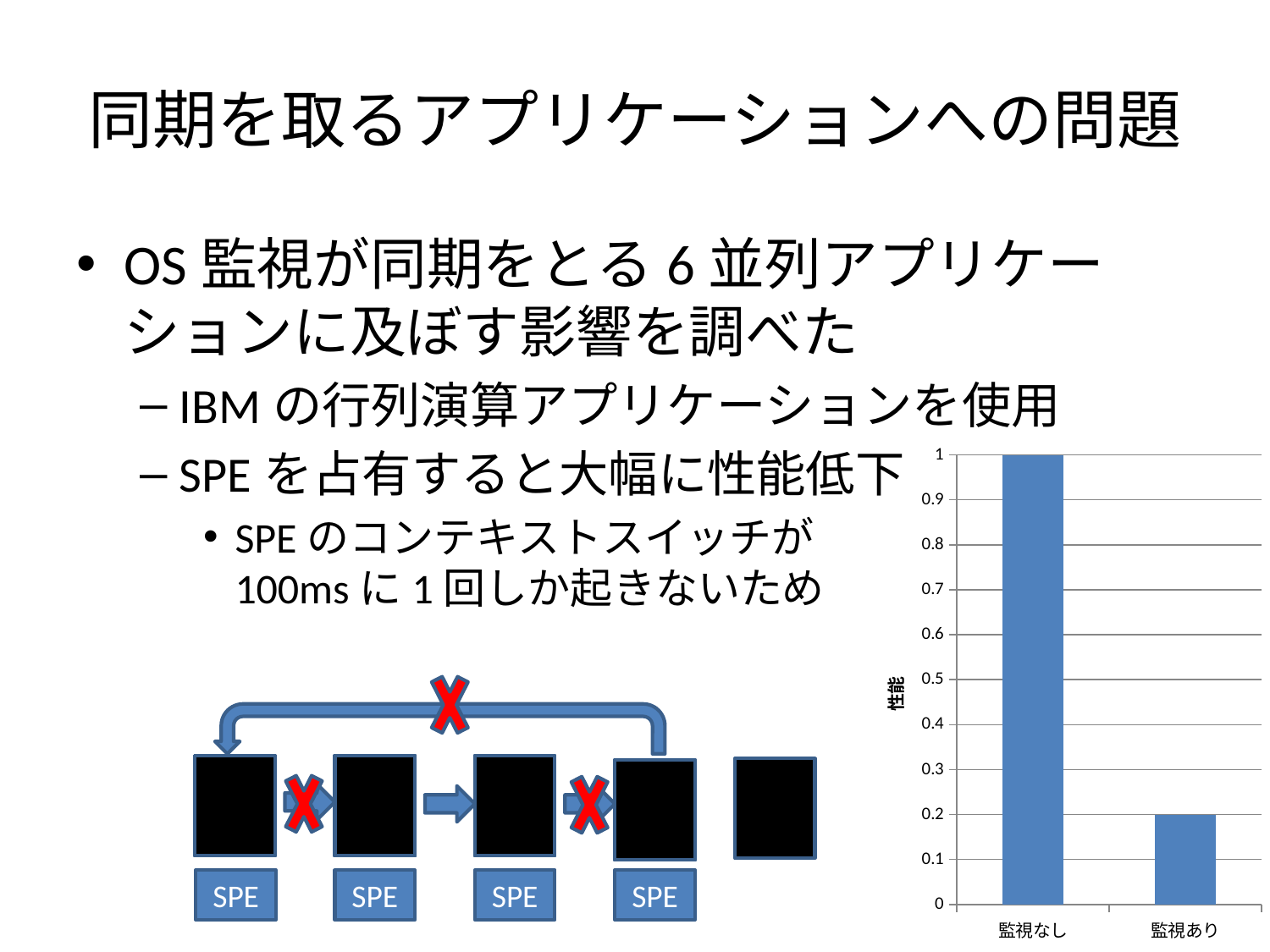
What is the value for 監視あり in the bar chart? 0.2 Which category has the lowest value in the bar chart? 監視あり Do the values rise or fall from 監視なし to 監視あり along the x axis? fall Which category has the highest value in the bar chart? 監視なし What is the value for 監視なし in the bar chart? 1 How many categories are plotted in the bar chart? 2 Which is larger, the value for 監視なし or the value for 監視あり? 監視なし Is the value for 監視あり greater or less than 0.5? less What is the difference between the values for 監視なし and 監視あり? 0.8 What is the label on the vertical axis of the bar chart? 性能 What kind of chart is shown on the slide? bar chart Is the value for 監視なし greater or less than 0.5? greater